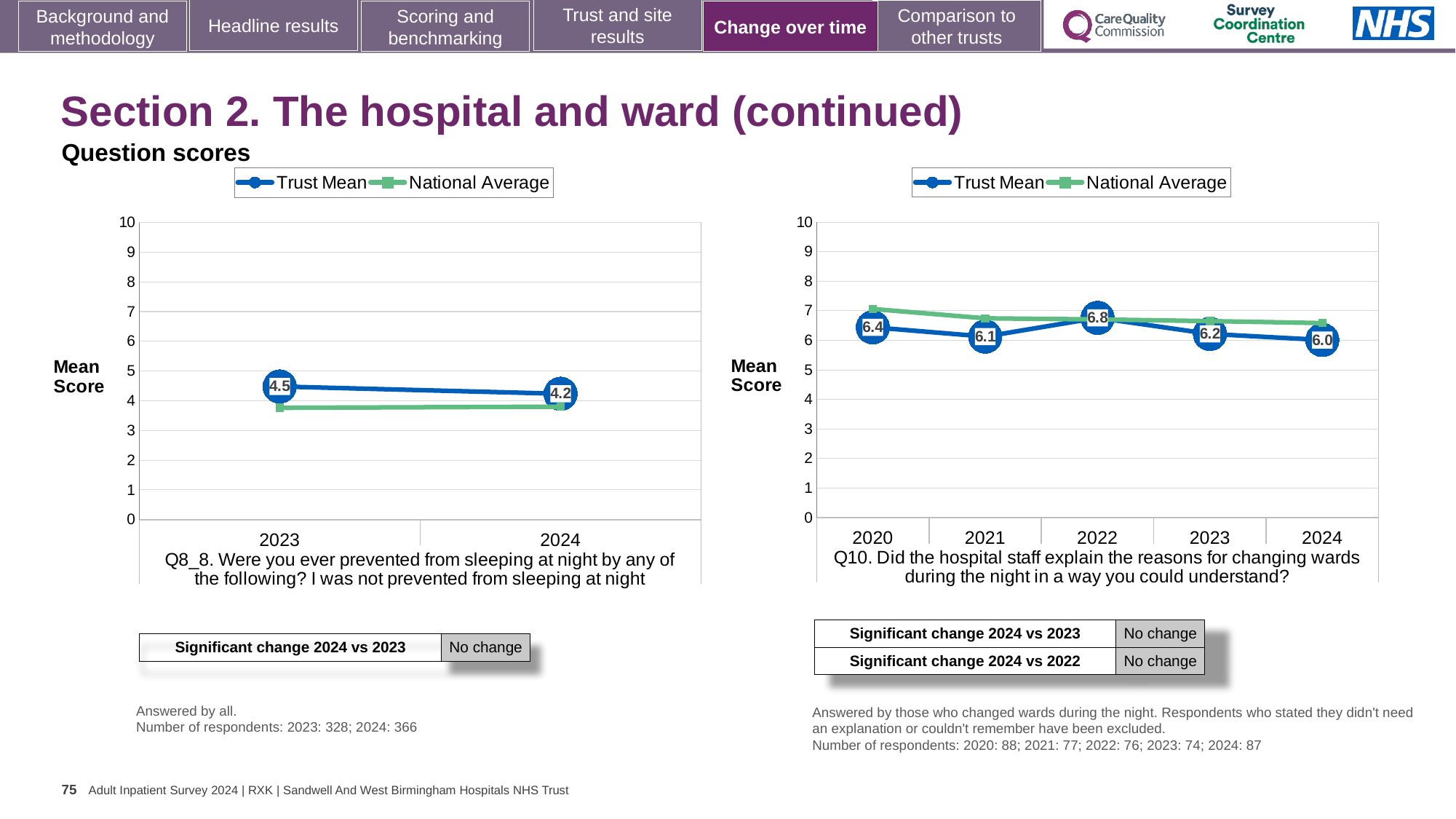
In the right chart (Q10), what is the difference between the Trust Mean scores for 2022 and 2024? 0.8 In the left chart (Q8_8), by how much did the Trust Mean fall from 2023 to 2024? 0.3 What type of chart is used for Q10 on the right of the slide? Line chart In the right chart (Q10), what is the Trust Mean score for 2022? 6.8 How many series does the legend of the left chart list? 2 In the right chart (Q10), is the Trust Mean for 2020 or 2021 higher? 2020 In the right chart (Q10), which year has the highest Trust Mean score? 2022 How many years are plotted on the x axis of the right chart (Q10)? 5 In the left chart (Q8_8), what is the Trust Mean score for 2023? 4.5 In the left chart (Q8_8), is the National Average for 2023 greater or less than 4? less In the left chart (Q8_8), what is the Trust Mean score for 2024? 4.2 In the right chart (Q10), which year has the lowest Trust Mean score? 2024